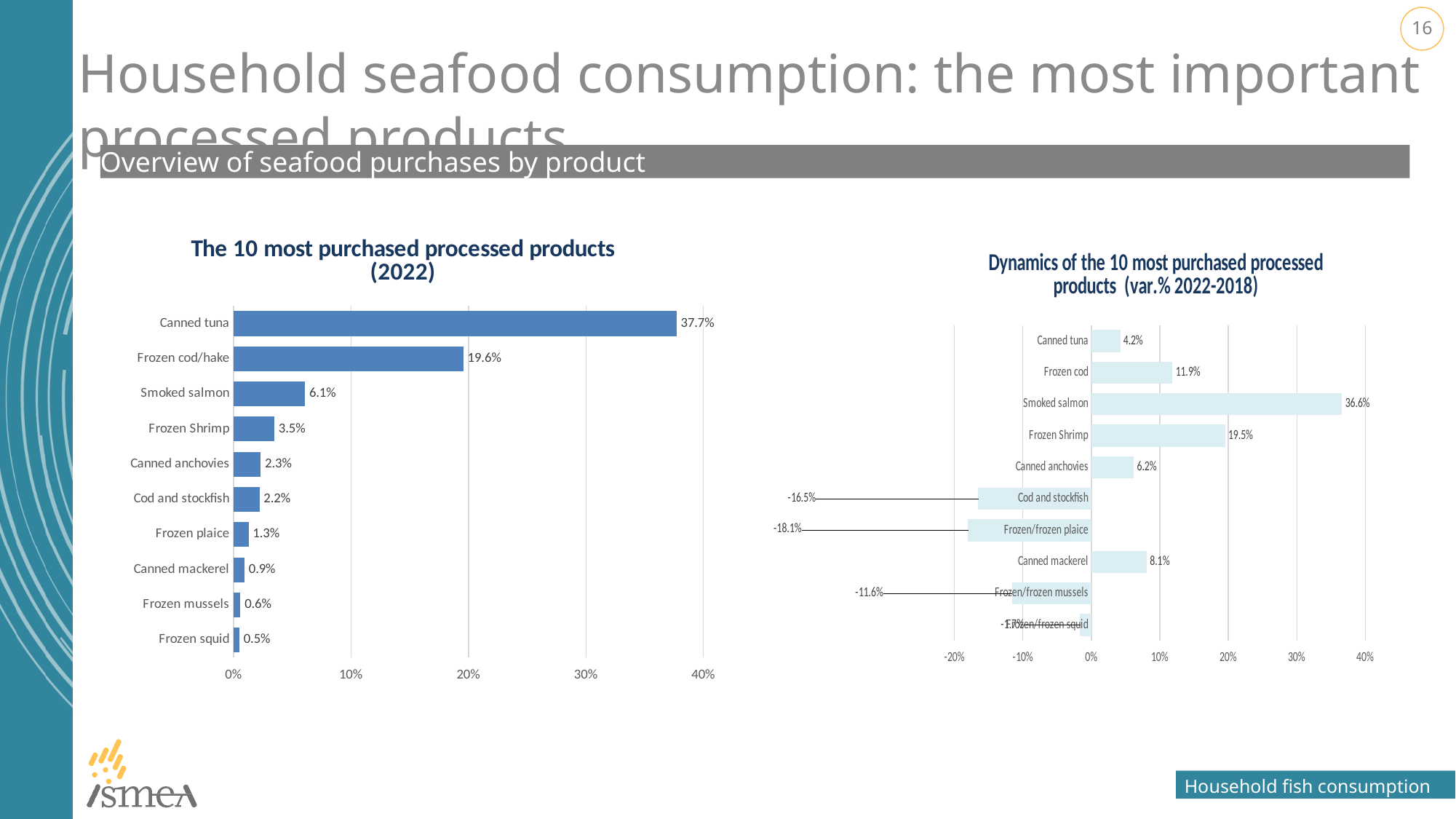
In the chart 'The 10 most purchased processed products (2022)', how many products are shown? 10 In the chart 'Dynamics of the 10 most purchased processed products (var.% 2022-2018)', what is the value for Smoked salmon? 36.6% In the chart 'Dynamics of the 10 most purchased processed products (var.% 2022-2018)', is the value for Frozen Shrimp greater or less than 10%? greater In the chart 'Dynamics of the 10 most purchased processed products (var.% 2022-2018)', what is the value for Frozen/frozen plaice? -18.1% In the chart 'Dynamics of the 10 most purchased processed products (var.% 2022-2018)', which is larger, the value for Frozen cod or the value for Canned mackerel? Frozen cod In the chart 'The 10 most purchased processed products (2022)', which product has the lowest value? Frozen squid In the chart 'The 10 most purchased processed products (2022)', what is the difference between Canned tuna and Frozen cod/hake? 18.1 percentage points What kind of chart is 'The 10 most purchased processed products (2022)'? Bar chart In the chart 'Dynamics of the 10 most purchased processed products (var.% 2022-2018)', which product has the highest value? Smoked salmon In the chart 'The 10 most purchased processed products (2022)', what is the value for Canned tuna? 37.7% In the chart 'The 10 most purchased processed products (2022)', what is the value for Frozen Shrimp? 3.5% In the chart 'Dynamics of the 10 most purchased processed products (var.% 2022-2018)', what is the value for Cod and stockfish? -16.5%